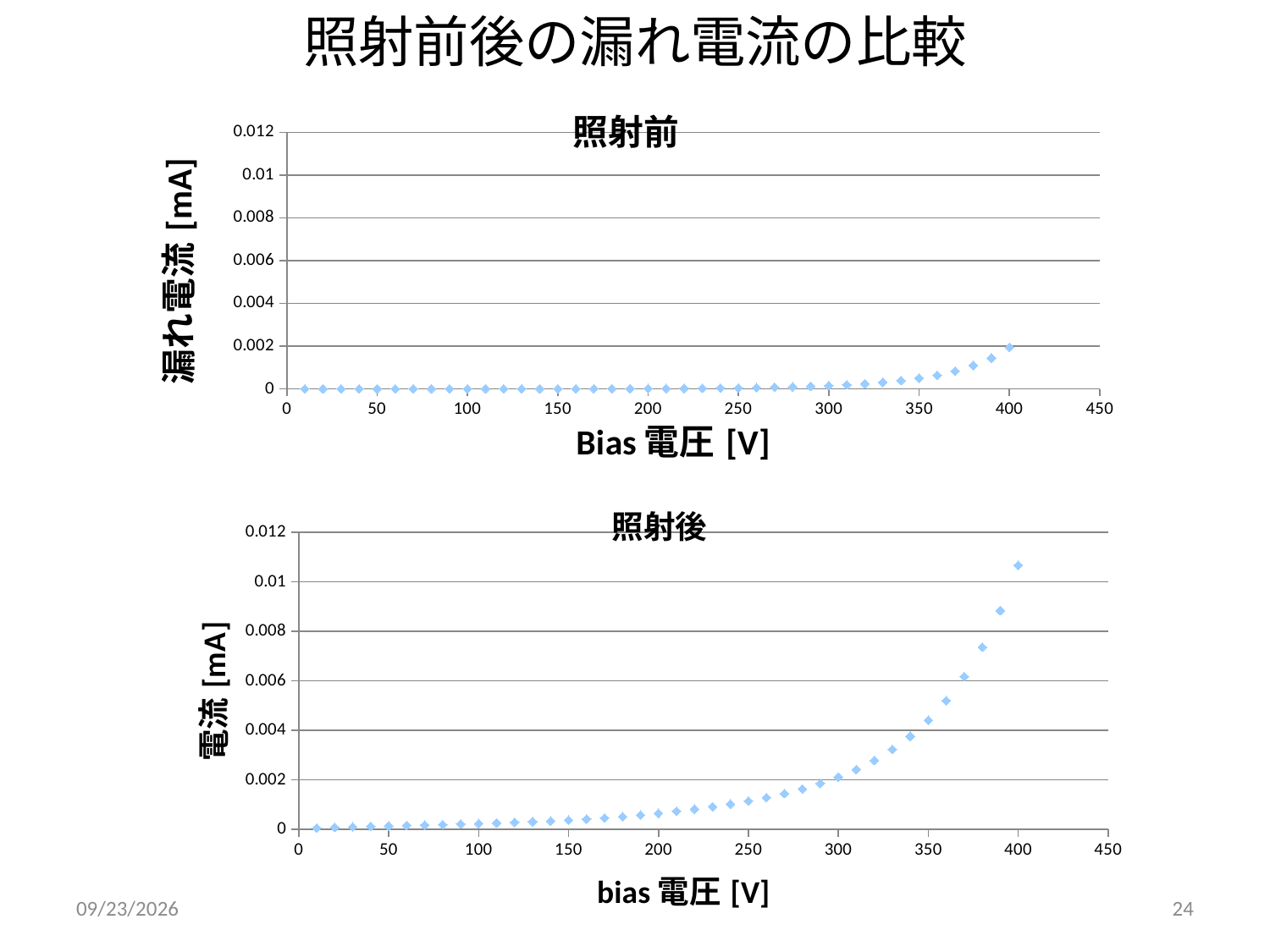
What kind of chart is the 照射後 chart? scatter chart In the 照射後 chart, is the value at 400 V greater or less than 0.01? greater In the 照射後 chart, at which bias voltage is the current highest? 400 What is the y-axis label of the 照射後 chart? 電流 [mA] Which chart has the larger value at 400 V, 照射前 or 照射後? 照射後 What is the x-axis label of the 照射前 chart? Bias 電圧 [V] In the 照射後 chart, is the value at 390 V greater or less than 0.008? greater What kind of chart is the 照射前 chart? scatter chart In the 照射後 chart, is the value at 350 V greater or less than 0.006? less In the 照射後 chart, do the values rise or fall as the bias voltage increases? rise